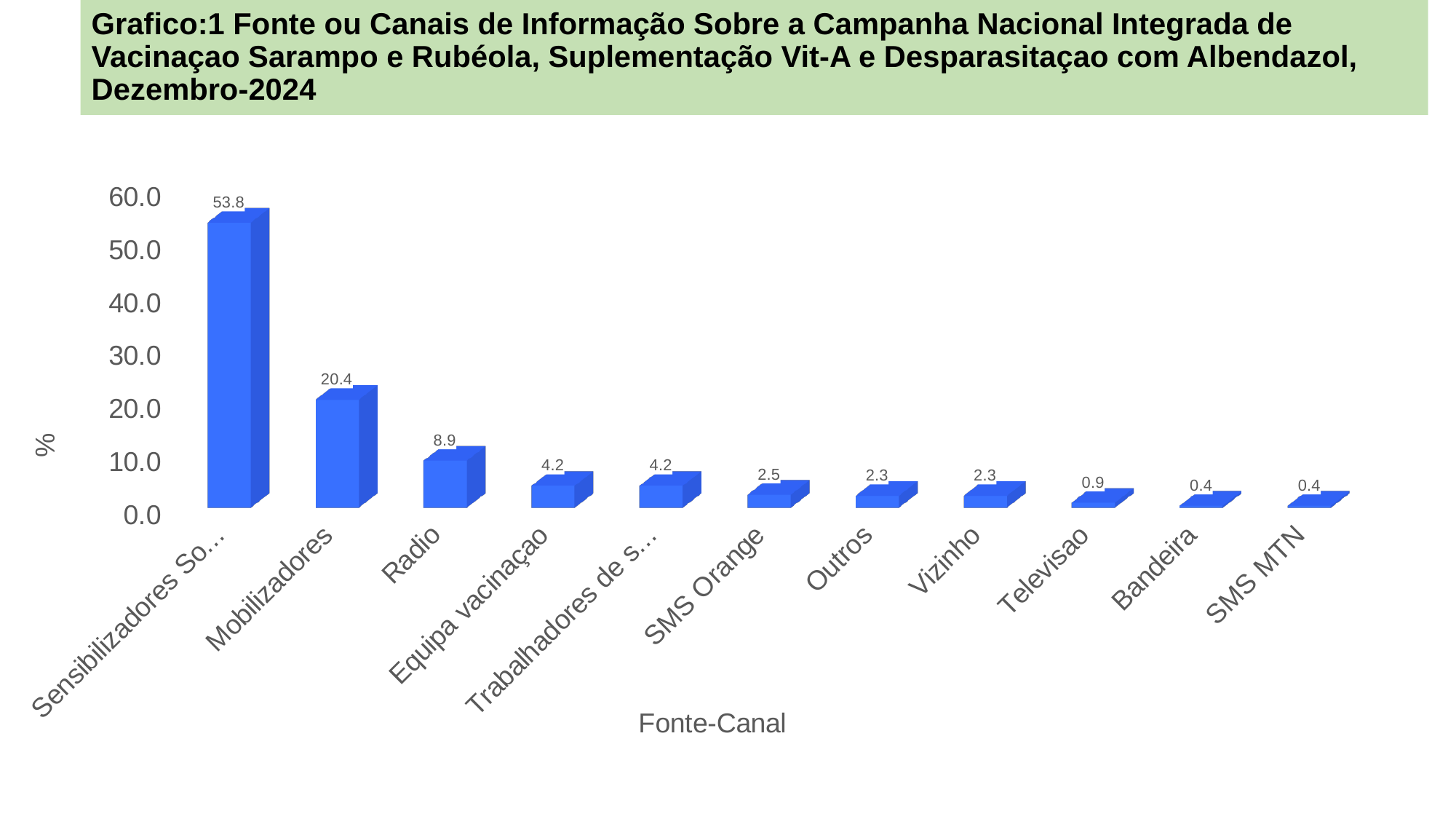
Which category has the highest value? Sensibilizadores So… What is the difference between the values for Mobilizadores and Radio? 11.5 What is the title of the x axis? Fonte-Canal What is the value for Bandeira? 0.4 What is the value for Radio? 8.9 Which is larger, the value for Radio or the value for Equipa vacinaçao? Radio What kind of chart is shown on the slide? bar chart How many categories are shown on the x axis? 11 What is the value for SMS Orange? 2.5 What is the value for Televisao? 0.9 Do the values rise or fall from left to right along the x axis? fall What is the value for Mobilizadores? 20.4